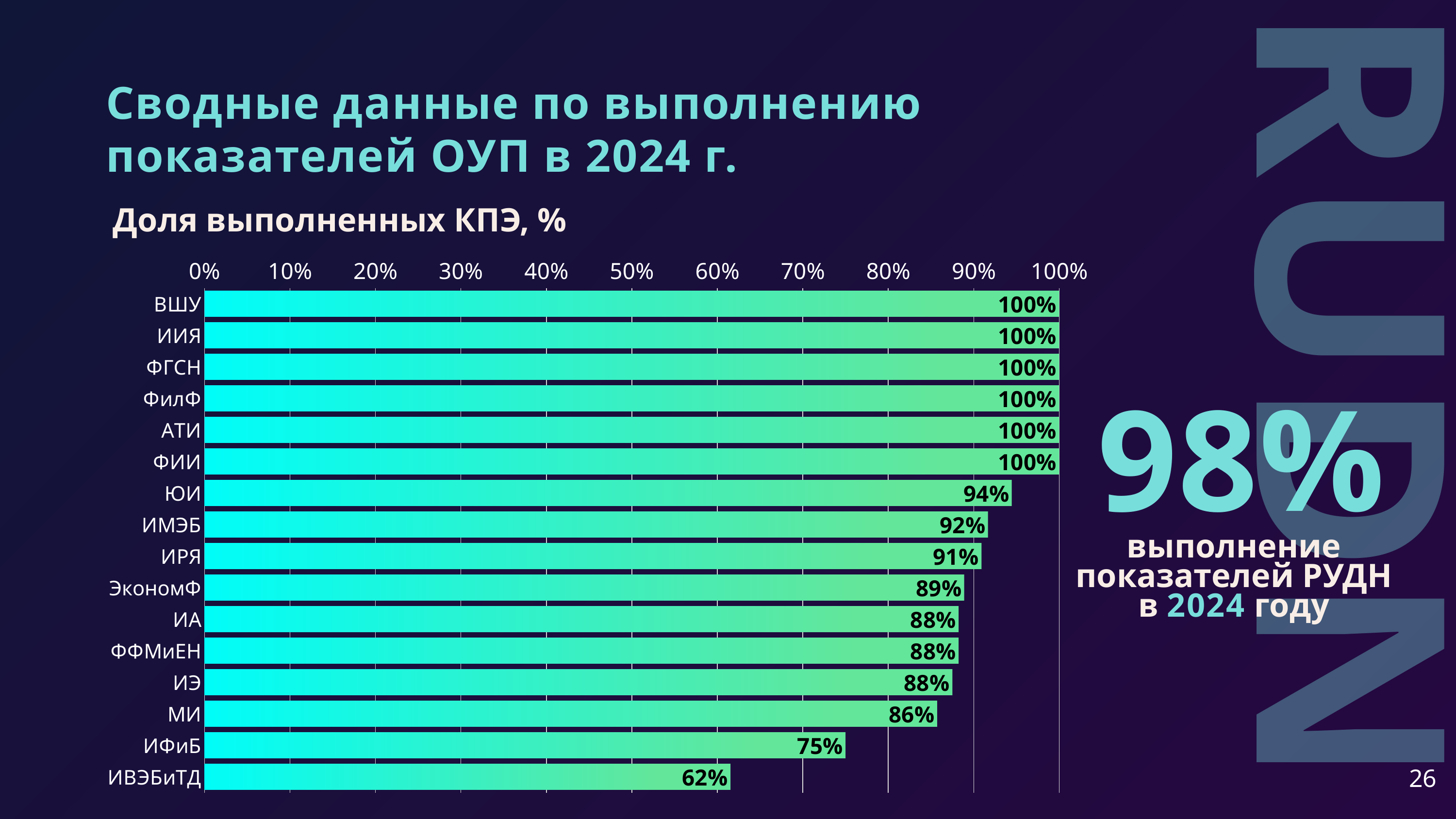
Which is larger, the value for ИМЭБ or the value for МИ? ИМЭБ How many categories are shown in the chart? 16 What is the difference between the values for ЮИ and ИВЭБиТД? 32 percentage points What is the title of the chart? Доля выполненных КПЭ, % What is the value for ЭкономФ? 89% What is the value for ЮИ? 94% What kind of chart is shown on the slide? bar chart What is the value for ИВЭБиТД? 62% What is the value for МИ? 86% Is the value for ИФиБ greater or less than 70%? greater What is the difference between the values for ИФиБ and ИВЭБиТД? 13 percentage points Which category has the lowest value? ИВЭБиТД